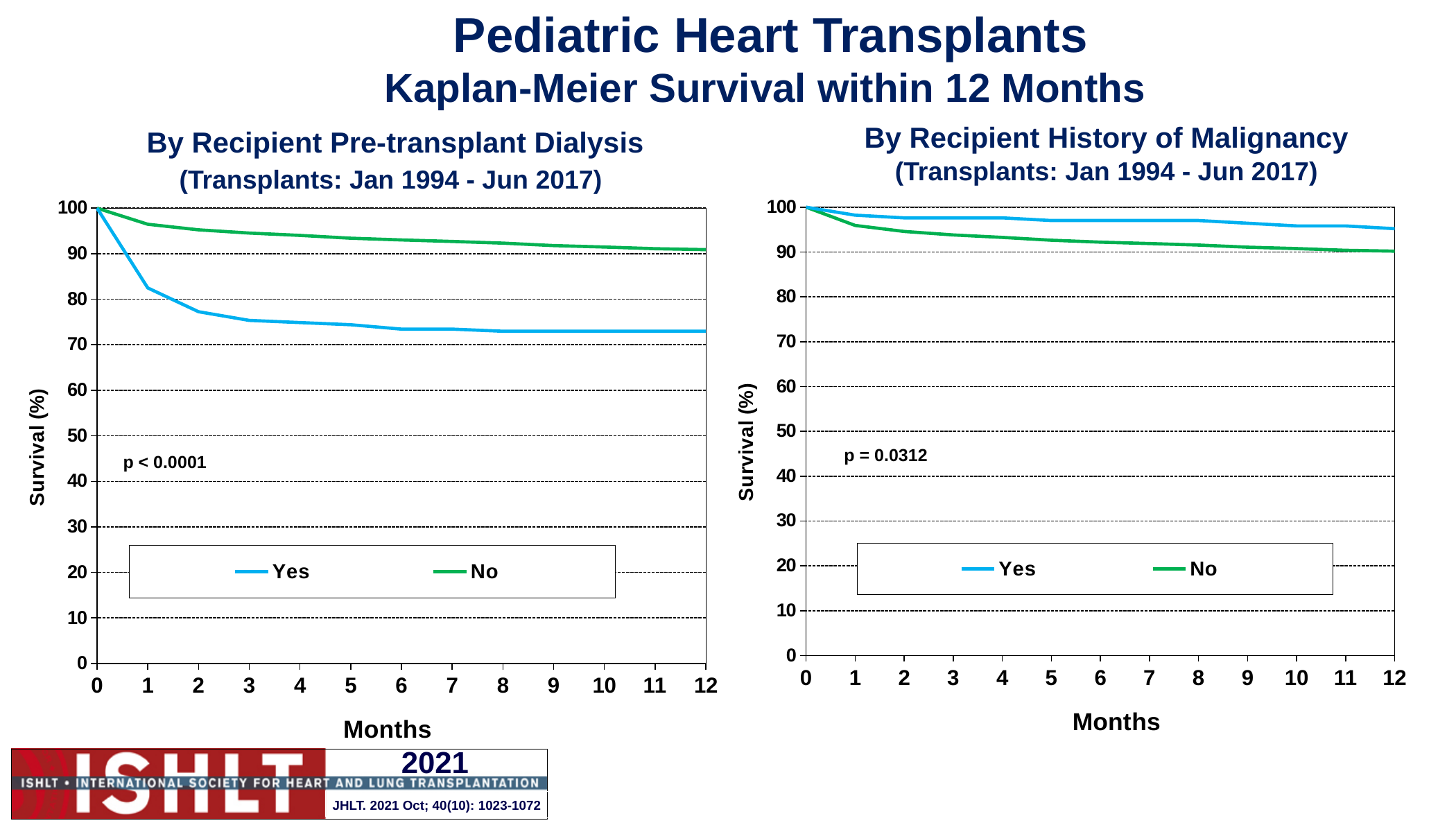
In the chart titled 'By Recipient History of Malignancy', which series has the higher survival at 12 months? Yes In the chart titled 'By Recipient History of Malignancy', what is the survival value for both series at month 0? 100 In the chart titled 'By Recipient Pre-transplant Dialysis', what kind of chart is shown? line chart In the chart titled 'By Recipient History of Malignancy', is the survival for the 'No' series at 12 months greater or less than 80? greater In the chart titled 'By Recipient Pre-transplant Dialysis', how many series does the legend list? 2 In the chart titled 'By Recipient Pre-transplant Dialysis', what p-value is shown? p < 0.0001 In the chart titled 'By Recipient Pre-transplant Dialysis', is the survival for the 'Yes' series at 12 months greater or less than 80? less In the chart titled 'By Recipient History of Malignancy', what colour is the 'No' series line? green In the chart titled 'By Recipient Pre-transplant Dialysis', do the survival values rise or fall as months increase? fall In the chart titled 'By Recipient Pre-transplant Dialysis', which series has the lower survival at 12 months? Yes In the chart titled 'By Recipient History of Malignancy', what p-value is shown? p = 0.0312